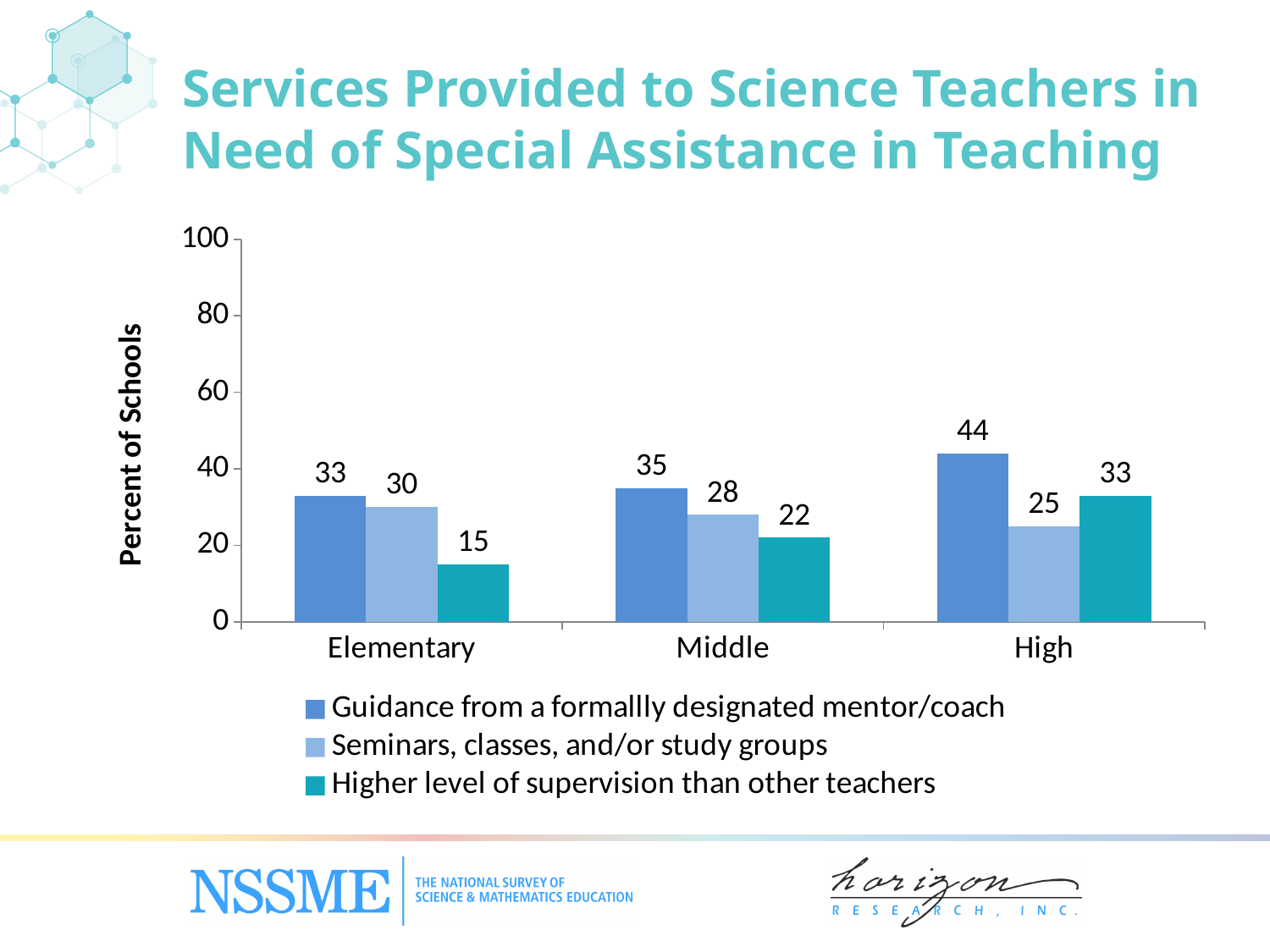
What is the difference between the percent of high schools and elementary schools providing guidance from a formally designated mentor/coach? 11 What percent of elementary schools provide guidance from a formally designated mentor/coach? 33 Which is larger for middle schools: the percent providing seminars, classes, and/or study groups or the percent providing a higher level of supervision than other teachers? Seminars, classes, and/or study groups How many school levels are shown on the x axis? 3 What percent of high schools provide seminars, classes, and/or study groups? 25 Which school level has the lowest percent of schools providing a higher level of supervision than other teachers? Elementary Is the value for high schools providing guidance from a formally designated mentor/coach greater or less than 40? greater What percent of middle schools provide a higher level of supervision than other teachers? 22 Which school level has the highest percent of schools providing guidance from a formally designated mentor/coach? High What is the label of the y axis? Percent of Schools What kind of chart is shown on the slide? Bar chart How many series does the legend list? 3